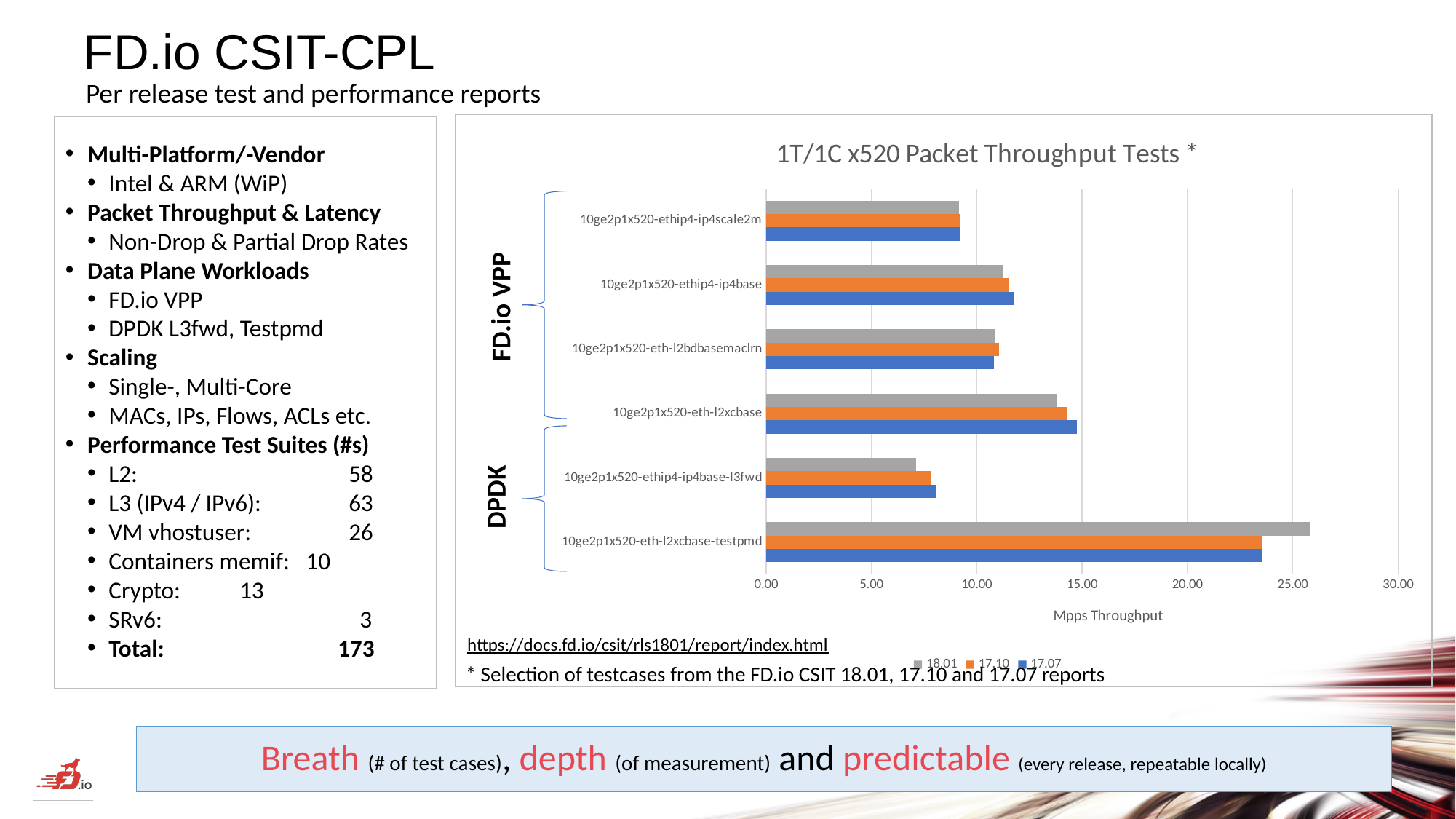
How many test case categories are plotted in the chart? 6 Which test case has the lowest 18.01 throughput in the chart? 10ge2p1x520-ethip4-ip4base-l3fwd What is the title of the chart? 1T/1C x520 Packet Throughput Tests * What is the label of the horizontal axis of the chart? Mpps Throughput For 10ge2p1x520-eth-l2xcbase-testpmd, which series has the larger value, 18.01 or 17.10? 18.01 Is the 18.01 value for 10ge2p1x520-ethip4-ip4base greater or less than 10.00? greater Is the 18.01 value for 10ge2p1x520-eth-l2xcbase-testpmd greater or less than 25.00? greater Which test case has the highest 18.01 throughput in the chart? 10ge2p1x520-eth-l2xcbase-testpmd What kind of chart is shown on the slide? bar chart Is the 18.01 value for 10ge2p1x520-ethip4-ip4base-l3fwd greater or less than 10.00? less How many series does the chart legend list? 3